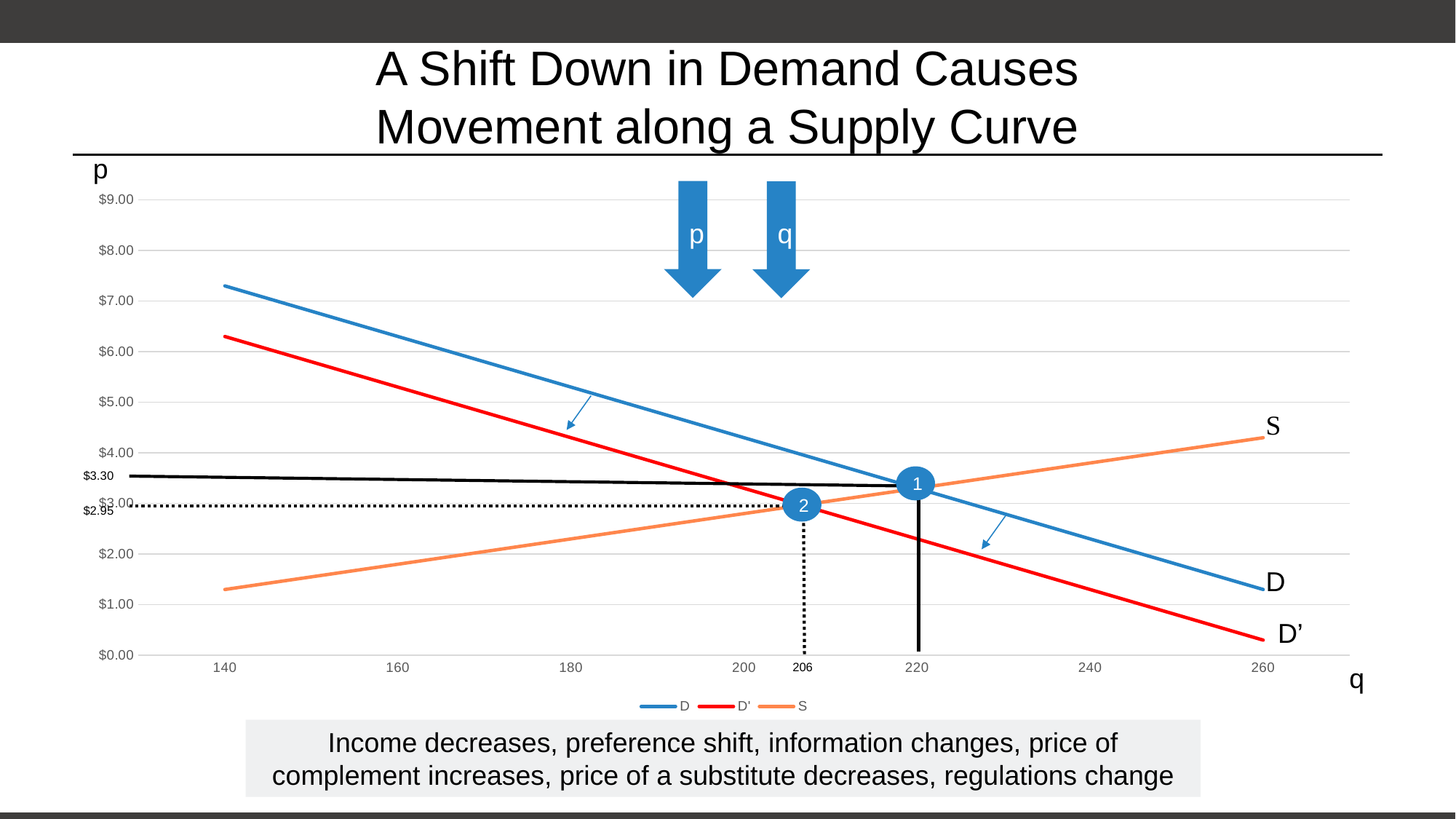
What are the three series named in the legend? D, D', S How many series does the legend list? 3 What is the quantity at equilibrium point 1? 220 What is the price at equilibrium point 2? $2.95 By how much does the quantity fall from equilibrium point 1 to equilibrium point 2? 14 Is the value of the S line at q = 140 greater or less than $2.00? less What is the price at equilibrium point 1? $3.30 By how much does the price fall from equilibrium point 1 to equilibrium point 2? $0.35 Does the S line rise or fall as q increases along the x axis? rise At q = 140, which line is higher, D or D'? D What is the quantity at equilibrium point 2? 206 What kind of chart is shown on the slide? line chart